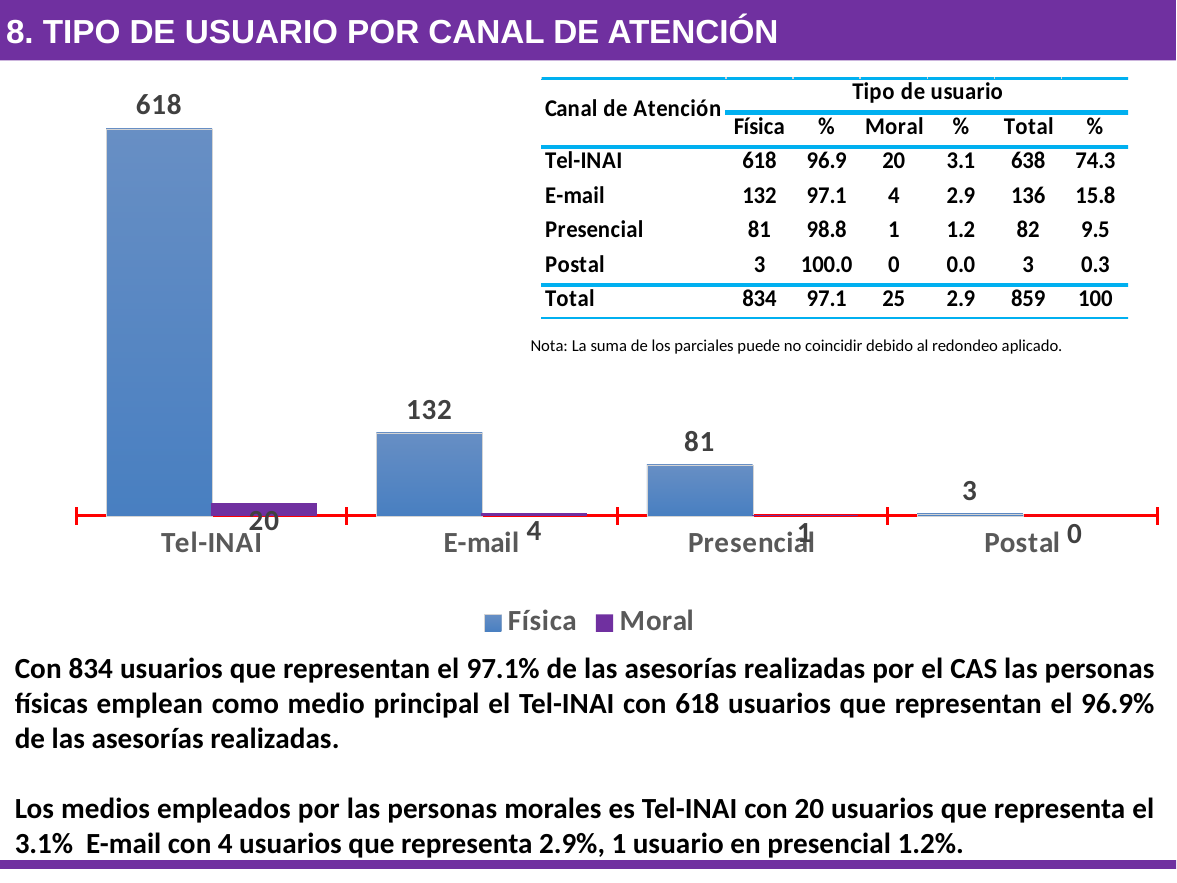
How many categories are shown on the x axis of the chart? 4 Which category has the highest Física value? Tel-INAI What is the value of the Moral series for Postal? 0 Which category has the lowest Física value? Postal What is the value of the Moral series for E-mail? 4 How many series does the chart legend list? 2 What is the value of the Física series for Tel-INAI? 618 Which series is shown in purple in the chart legend? Moral What is the difference between the Física values for Tel-INAI and E-mail? 486 Which is larger, the Moral value for Tel-INAI or the Moral value for E-mail? Tel-INAI What is the value of the Física series for Presencial? 81 What kind of chart is shown on the slide? Bar chart